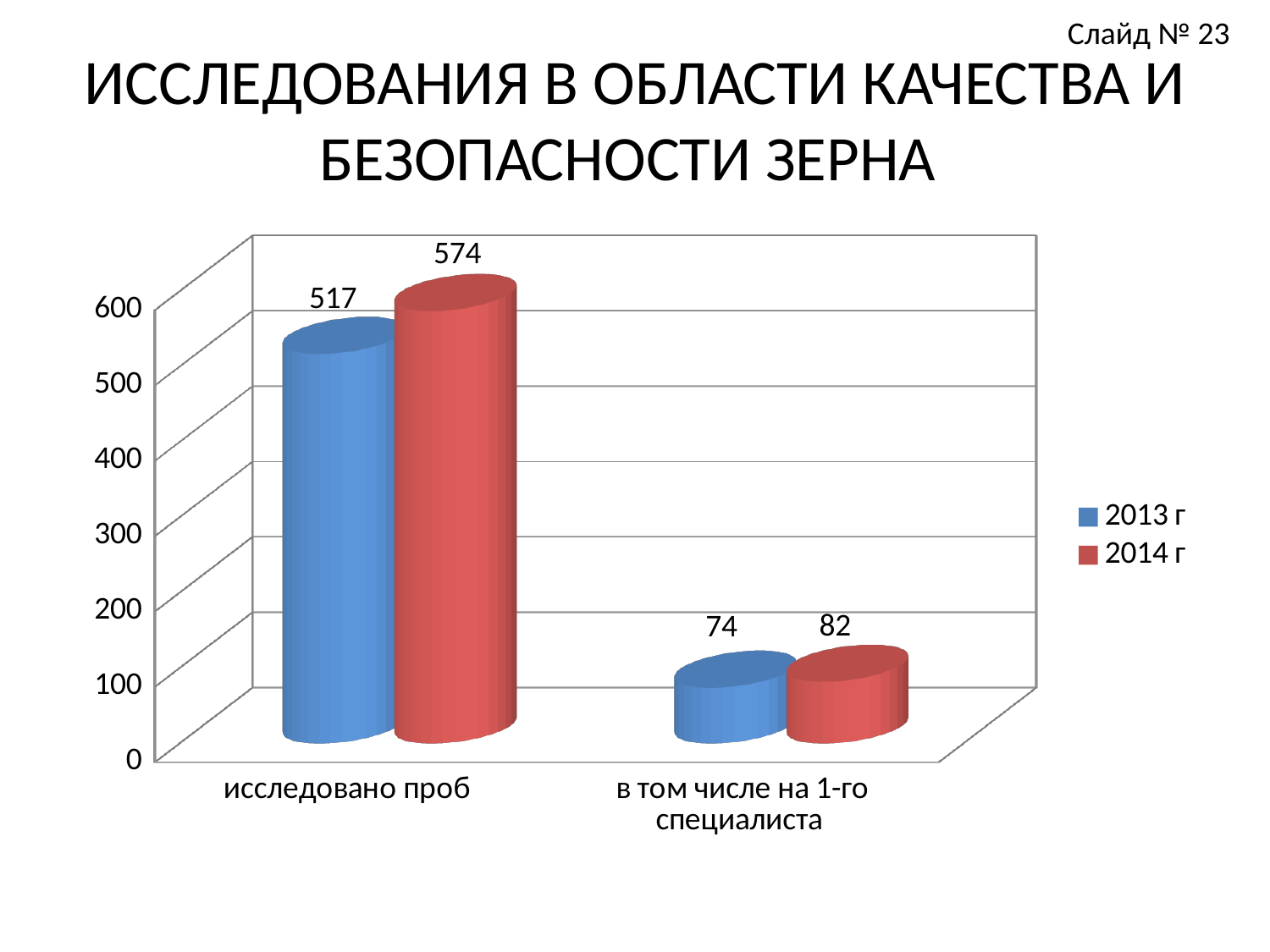
Which category has the lowest value across both series? в том числе на 1-го специалиста (2013 г, 74) What is the value for 2014 г in the category "исследовано проб"? 574 What is the value for 2014 г in the category "в том числе на 1-го специалиста"? 82 What is the value for 2013 г in the category "исследовано проб"? 517 Which series has the higher value for "исследовано проб", 2013 г or 2014 г? 2014 г What is the difference between the 2014 г and 2013 г values for "исследовано проб"? 57 How many categories are shown on the x axis? 2 Which colour represents the 2014 г series? Red What is the value for 2013 г in the category "в том числе на 1-го специалиста"? 74 How many series does the legend list? 2 What kind of chart is shown on the slide? Bar chart What is the difference between the 2014 г and 2013 г values for "в том числе на 1-го специалиста"? 8